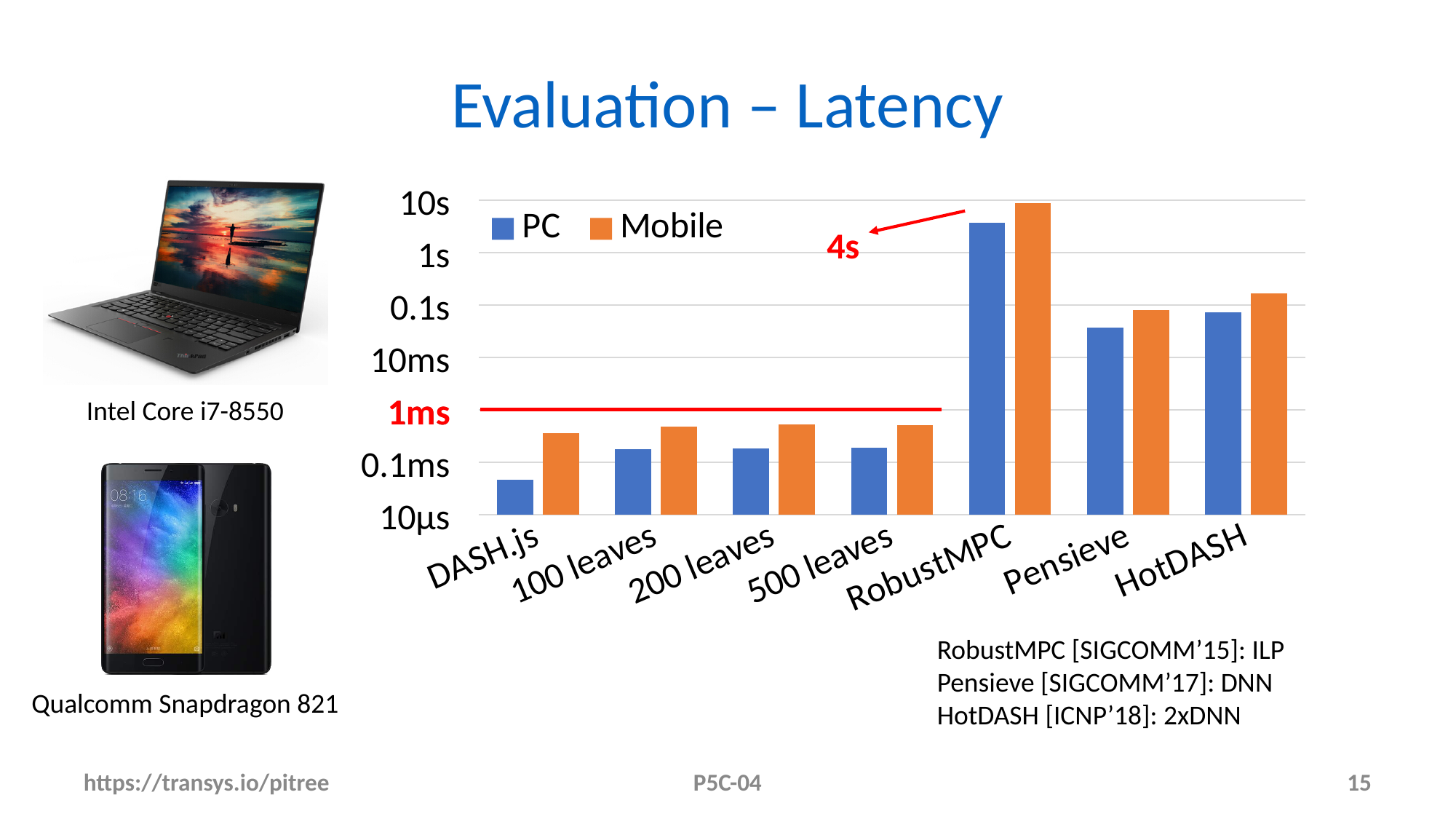
Which category has the highest latency in the chart? RobustMPC Which two series are listed in the chart's legend? PC and Mobile Is the Mobile latency for DASH.js greater or less than 1ms? less For DASH.js, which is larger: the PC latency or the Mobile latency? Mobile What latency level does the red horizontal line in the chart mark? 1ms What kind of chart is shown on the slide? bar chart How many series does the chart's legend list? 2 Which category has the lowest PC latency in the chart? DASH.js Is the PC latency for Pensieve greater or less than 0.1s? less How many categories are shown on the x axis of the chart? 7 What latency value is annotated for the RobustMPC PC bar? 4s Is the PC latency for RobustMPC greater or less than 1s? greater